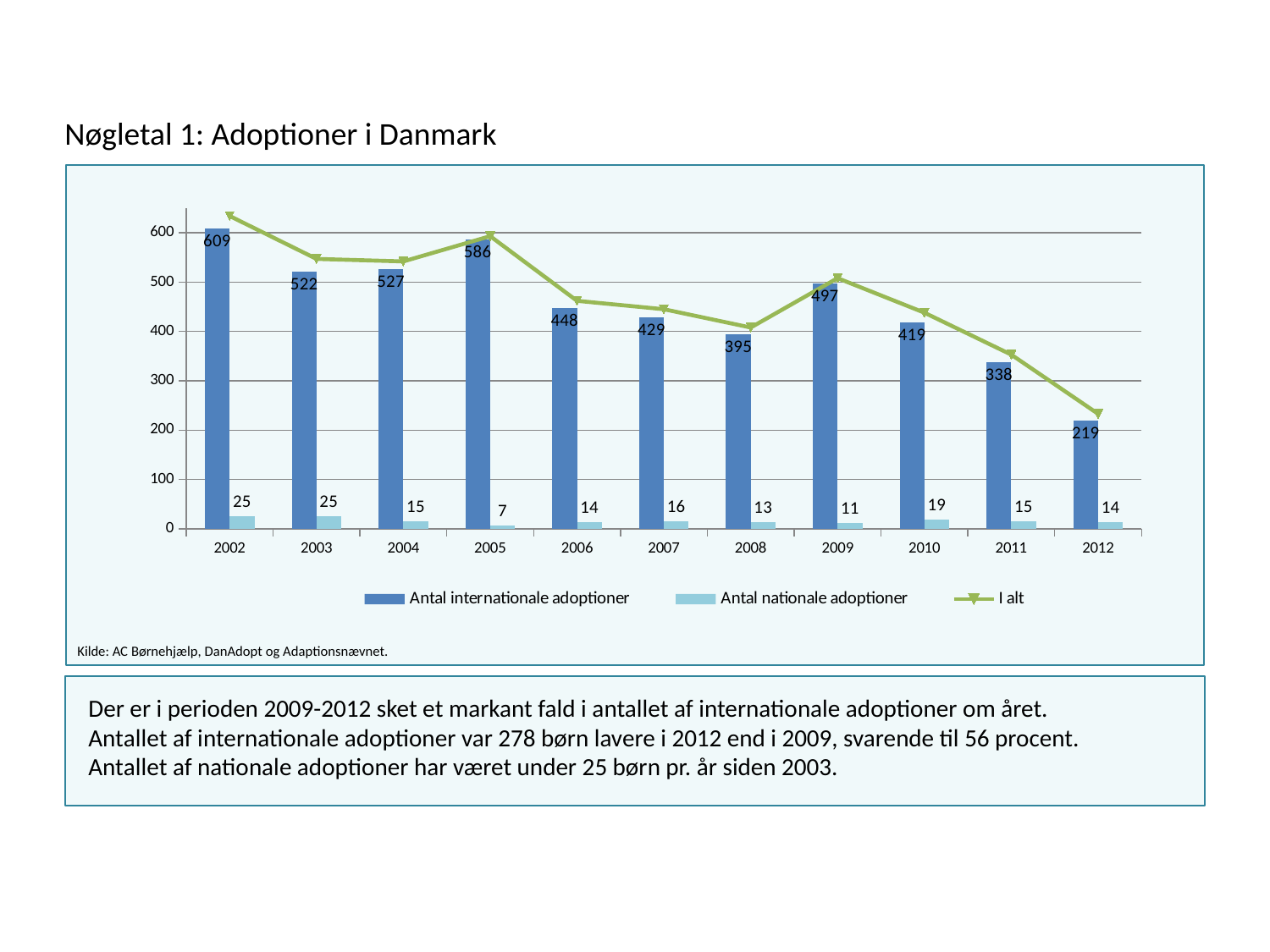
What is the value of Antal nationale adoptioner for 2005? 7 Which year has the highest value for Antal internationale adoptioner? 2002 What is the value of Antal internationale adoptioner for 2012? 219 Is the I alt value for 2012 greater or less than 300? less What kind of chart is used for Antal internationale adoptioner? bar chart What is the difference between Antal internationale adoptioner in 2009 and 2012? 278 Which year has the lowest value for Antal internationale adoptioner? 2012 What is the source cited below the chart? AC Børnehjælp, DanAdopt og Adaptionsnævnet Which is larger, Antal internationale adoptioner in 2005 or in 2004? 2005 What is the value of Antal internationale adoptioner for 2002? 609 How many years are shown on the x axis? 11 How many series does the legend list? 3